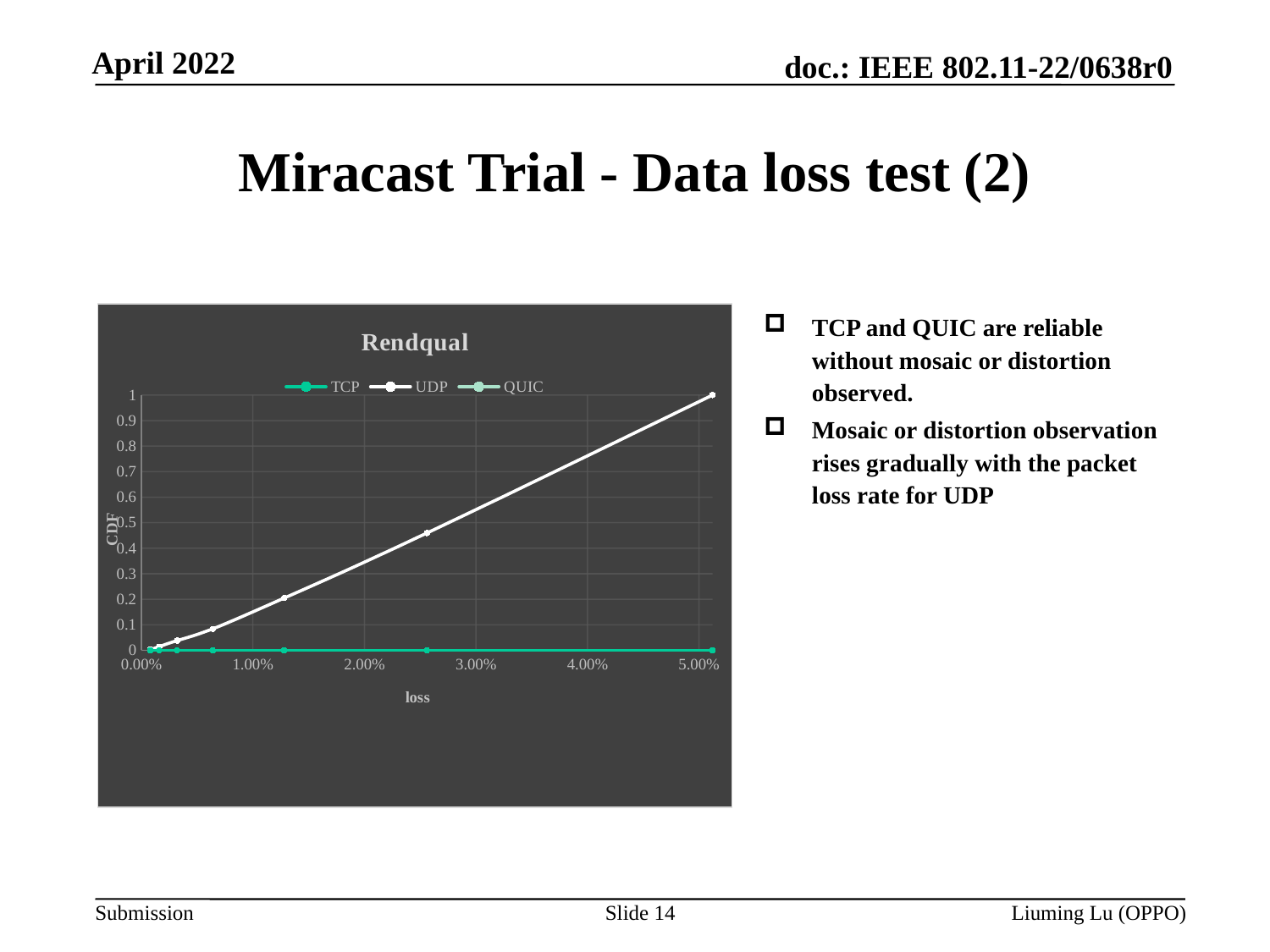
At 3.00% loss, which series has the larger CDF value, UDP or TCP? UDP What is the label of the x axis of the chart? loss What is the title of the chart? Rendqual Is the CDF value for UDP at 1.00% loss greater or less than 0.3? less Does the UDP line rise or fall as loss increases along the x axis? rise Is the CDF value for UDP at 5.00% loss greater or less than 0.9? greater Which series reaches the highest CDF value in the chart? UDP Is the CDF value for UDP at 2.00% loss greater or less than 0.5? less How many series does the legend of the chart list? 3 What kind of chart is shown on the slide? line chart Does the QUIC line rise, fall, or stay flat as loss increases? stay flat What CDF value does the TCP line stay at across the whole loss range? 0